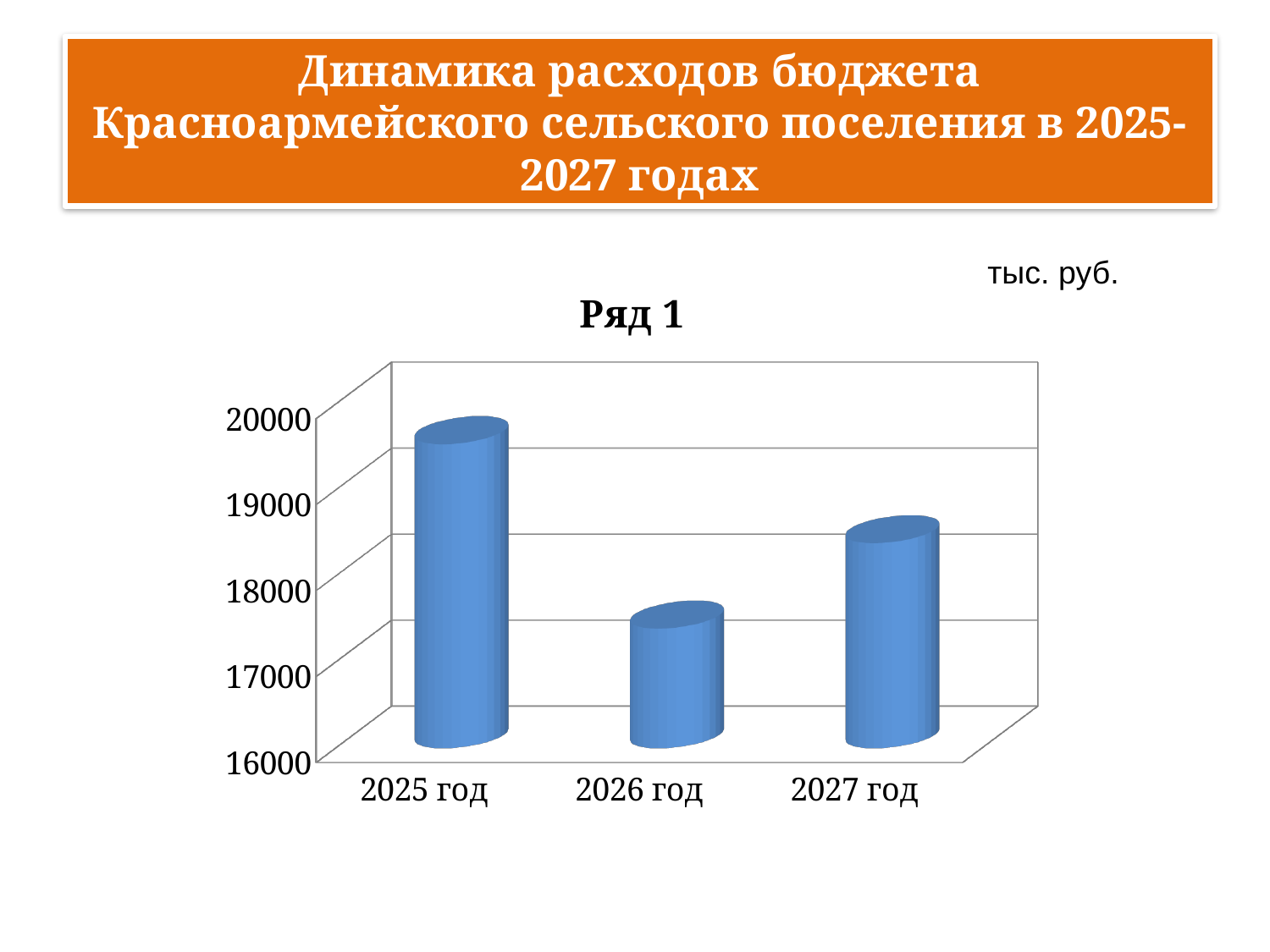
Is the value for 2025 год greater or less than 19000? greater Does the value rise or fall from 2025 год to 2026 год? fall Which year has the highest budget expenditure on the chart? 2025 год Is the value for 2026 год greater or less than 18000? less In what units are the chart values given, according to the label on the slide? тыс. руб. Is the value for 2027 год greater or less than 18000? greater Which is larger, the value for 2025 год or the value for 2027 год? 2025 год What kind of chart is shown on the slide? Bar chart Which year has the lowest budget expenditure on the chart? 2026 год What is the title shown above the chart? Ряд 1 How many categories (years) are plotted on the chart? 3 Which is larger, the value for 2027 год or the value for 2026 год? 2027 год